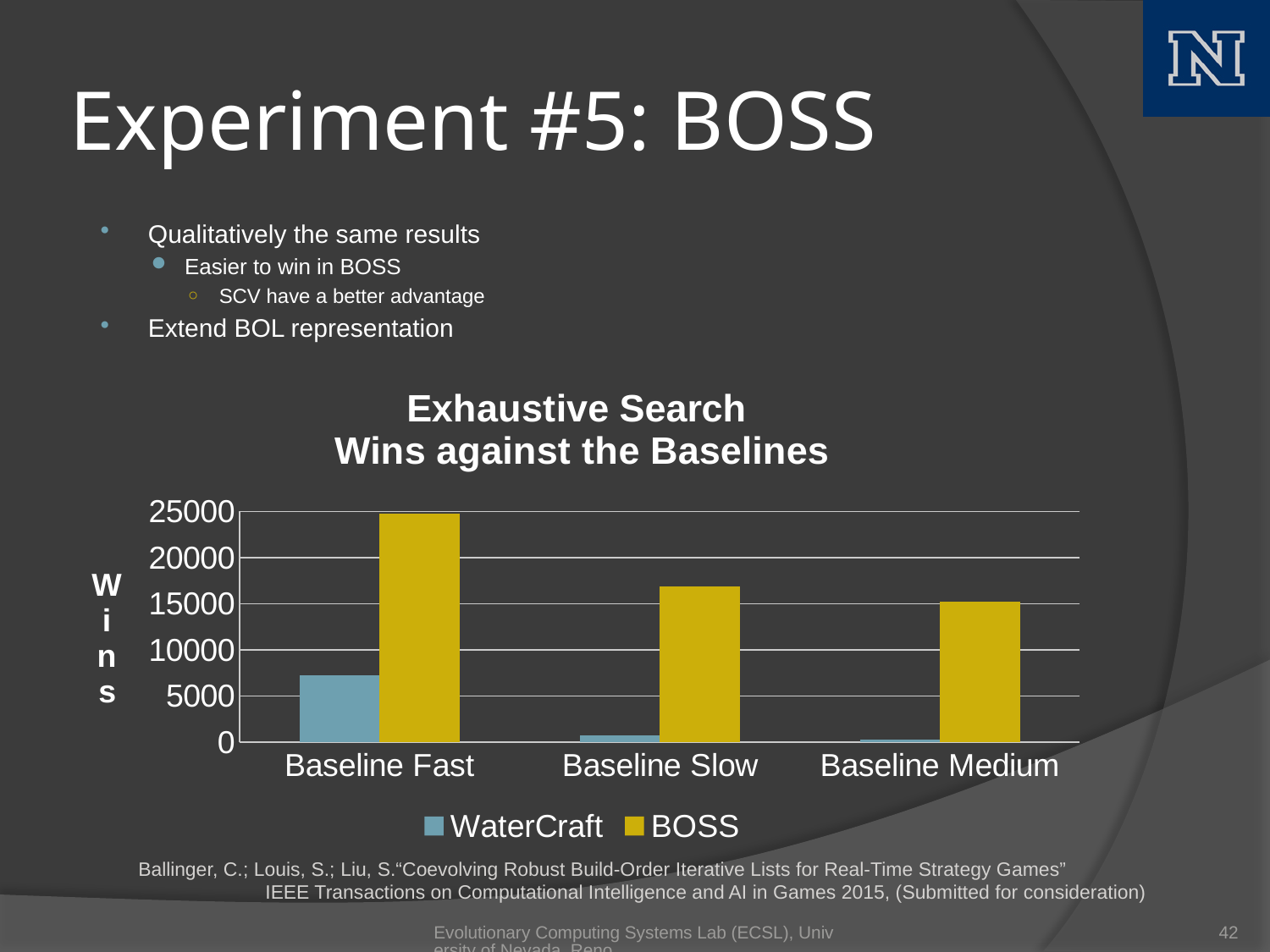
For which baseline does BOSS have the most wins? Baseline Fast Is the BOSS value for Baseline Fast greater or less than 20000? greater Is the WaterCraft value for Baseline Fast greater or less than 10000? less How many baseline categories are shown on the x axis? 3 Which series is shown in yellow? BOSS Do the BOSS wins rise or fall from Baseline Fast to Baseline Medium? fall Is the BOSS value for Baseline Slow greater or less than 15000? greater What is the title of the chart? Exhaustive Search Wins against the Baselines How many series does the legend list? 2 For which baseline does BOSS have the fewest wins? Baseline Medium What kind of chart is shown on the slide? bar chart For which baseline does WaterCraft have the most wins? Baseline Fast